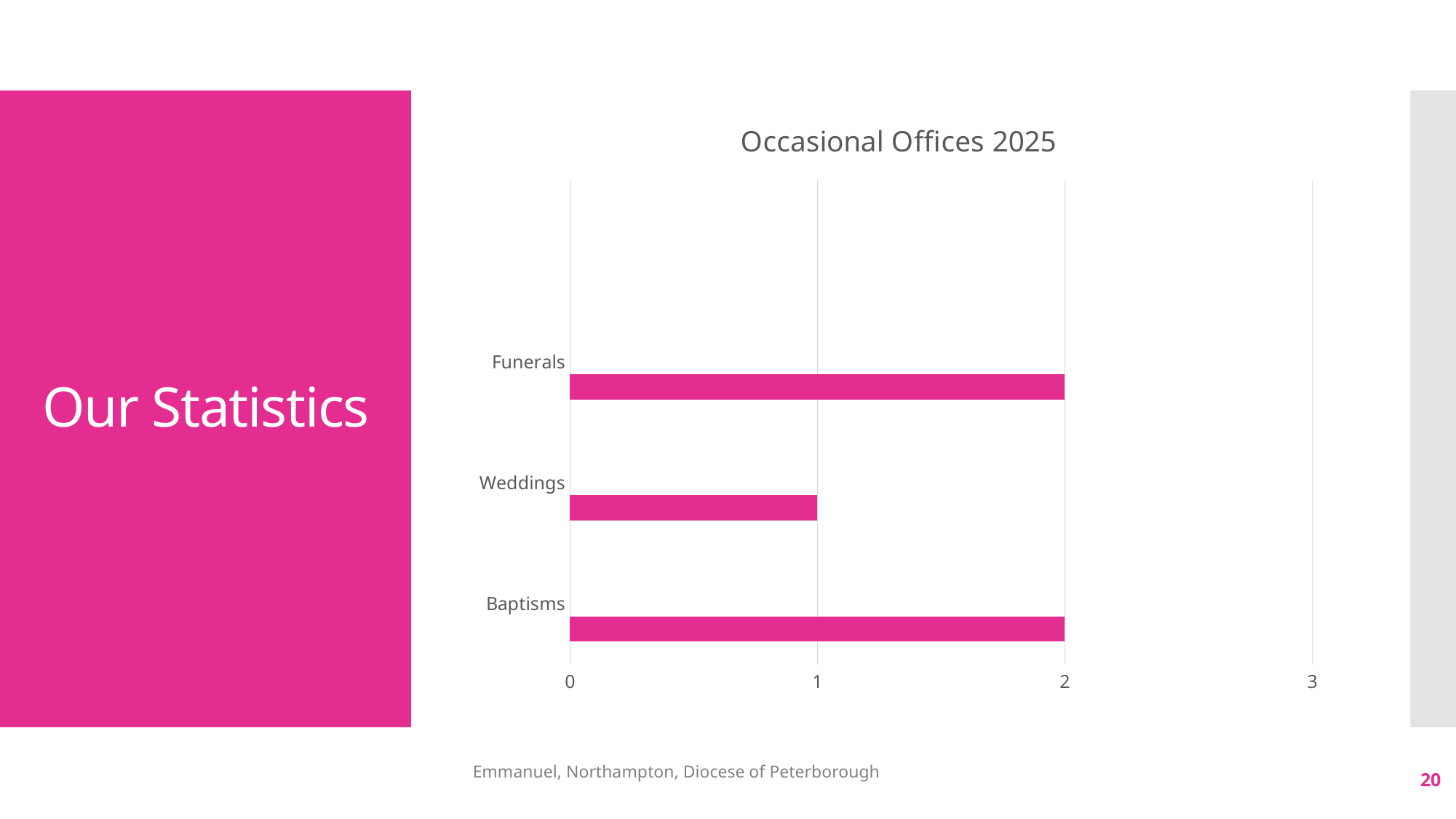
What is the value for Weddings? 1 What is the value for Funerals? 2 Which is larger, the value for Baptisms or the value for Weddings? Baptisms What is the difference between the values for Funerals and Weddings? 1 What is the value for Baptisms? 2 Is the value for Funerals greater or less than 1? greater Is the value for Weddings greater or less than 2? less What is the title of the chart? Occasional Offices 2025 How many categories are shown in the chart? 3 What is the highest value shown on the x axis? 3 What kind of chart is shown on the slide? bar chart Which category has the lowest value? Weddings